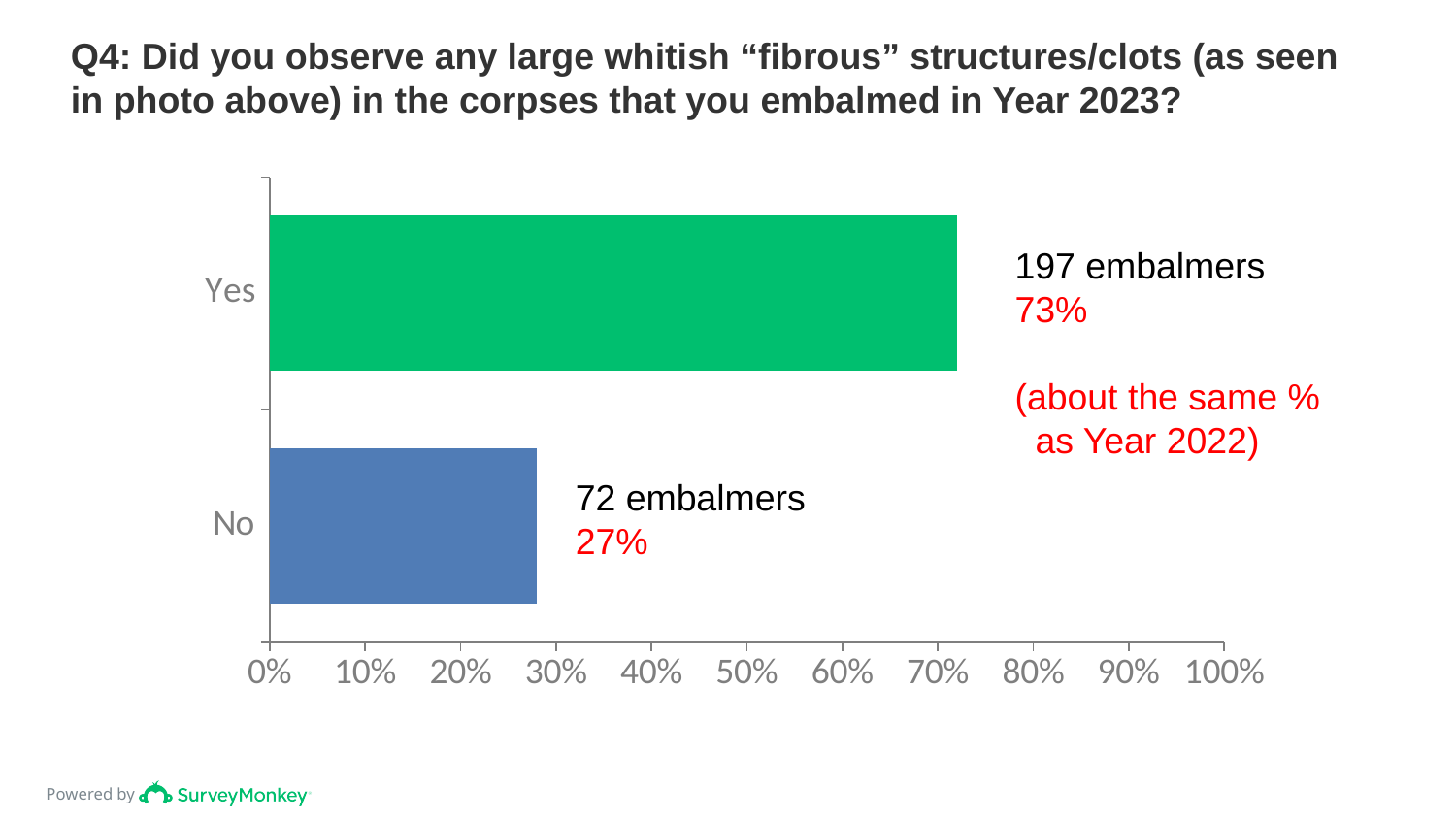
What kind of chart is shown on the slide? Bar chart How many more embalmers answered "Yes" than "No"? 125 Which response category has the highest value? Yes How many embalmers answered "No"? 72 embalmers How many embalmers answered "Yes"? 197 embalmers How many response categories are shown in the chart? 2 Which is larger, the value for "Yes" or the value for "No"? Yes What percentage of embalmers answered "Yes"? 73% What is the difference in percentage points between the "Yes" and "No" responses? 46% Is the value for "Yes" greater or less than 50%? greater Which response category has the lowest value? No What percentage of embalmers answered "No"? 27%